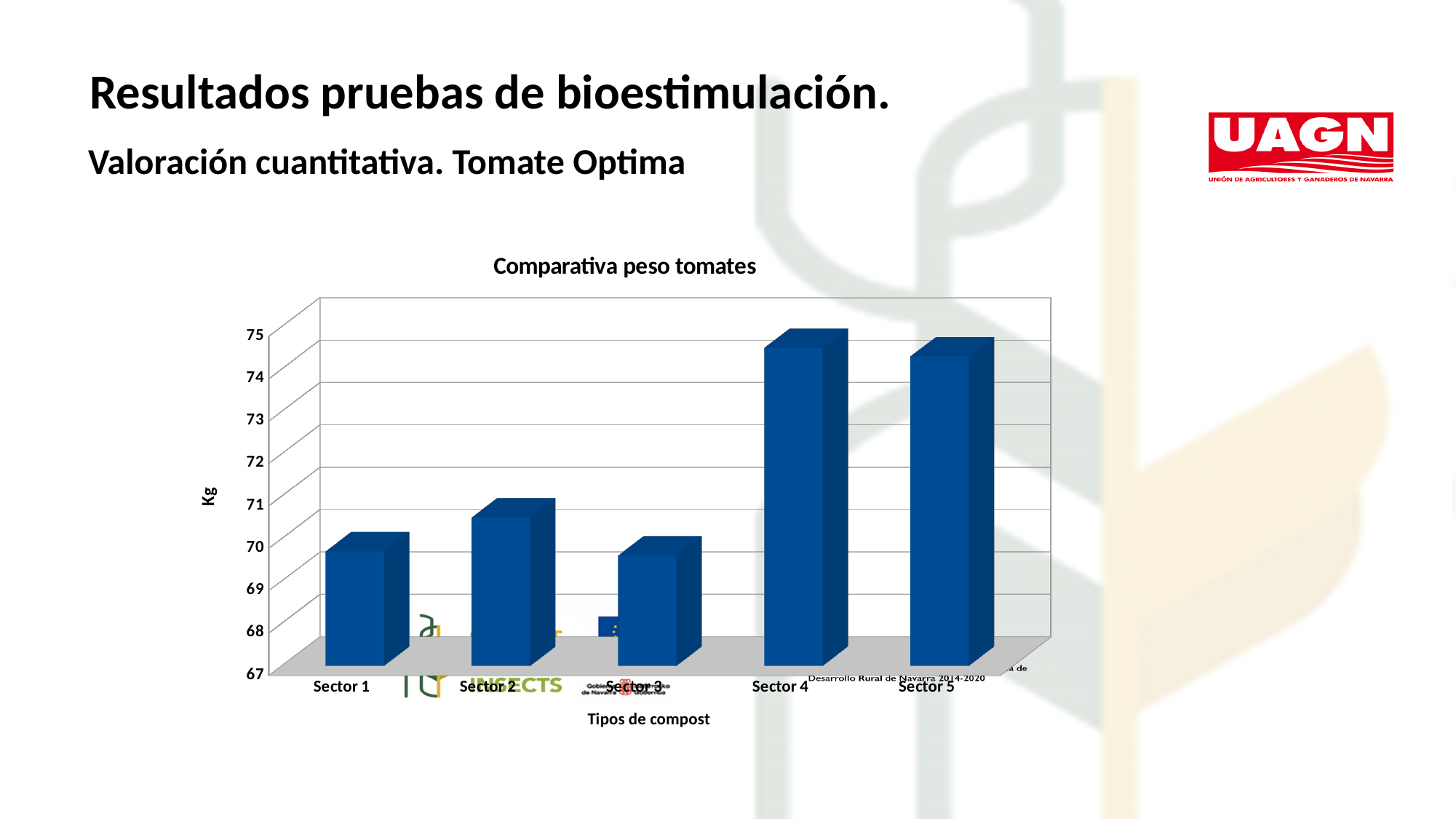
Is the value for Sector 3 greater or less than 71? less Which has a higher value, Sector 2 or Sector 3? Sector 2 What is the label of the vertical axis? Kg Is the value for Sector 5 greater or less than 73? greater Is the value for Sector 4 greater or less than 73? greater How many sectors (categories) are plotted in the chart? 5 Which has a higher value, Sector 5 or Sector 1? Sector 5 What is the title of the chart? Comparativa peso tomates Which has a higher value, Sector 4 or Sector 2? Sector 4 What type of chart is shown on the slide? bar chart